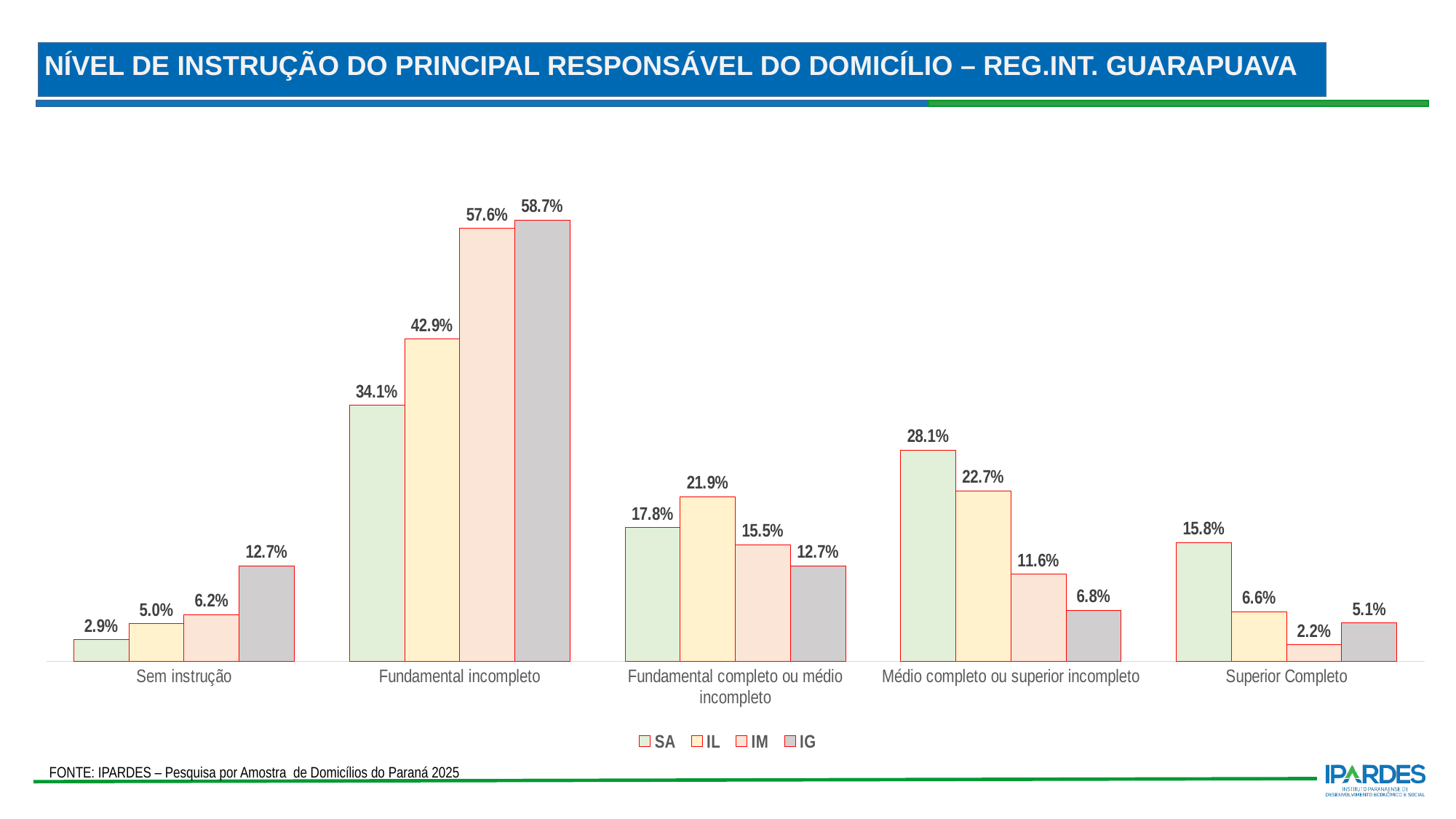
What is the difference between the IG and SA values in the Fundamental incompleto category? 24.6% How many categories are shown on the x axis? 5 Which series has the lowest value in the Médio completo ou superior incompleto category? IG Which is larger: the IL value for Fundamental completo ou médio incompleto or the IL value for Médio completo ou superior incompleto? Médio completo ou superior incompleto What is the value for SA in the Fundamental incompleto category? 34.1% Which series has the highest value in the Fundamental incompleto category? IG What is the source cited at the bottom of the slide? IPARDES – Pesquisa por Amostra de Domicílios do Paraná 2025 Across the categories from left to right, do the IG values rise or fall after Fundamental incompleto? Fall How many series does the legend list? 4 What is the value for IM in the Superior Completo category? 2.2% What is the value for IG in the Sem instrução category? 12.7% What kind of chart is shown on the slide? Bar chart